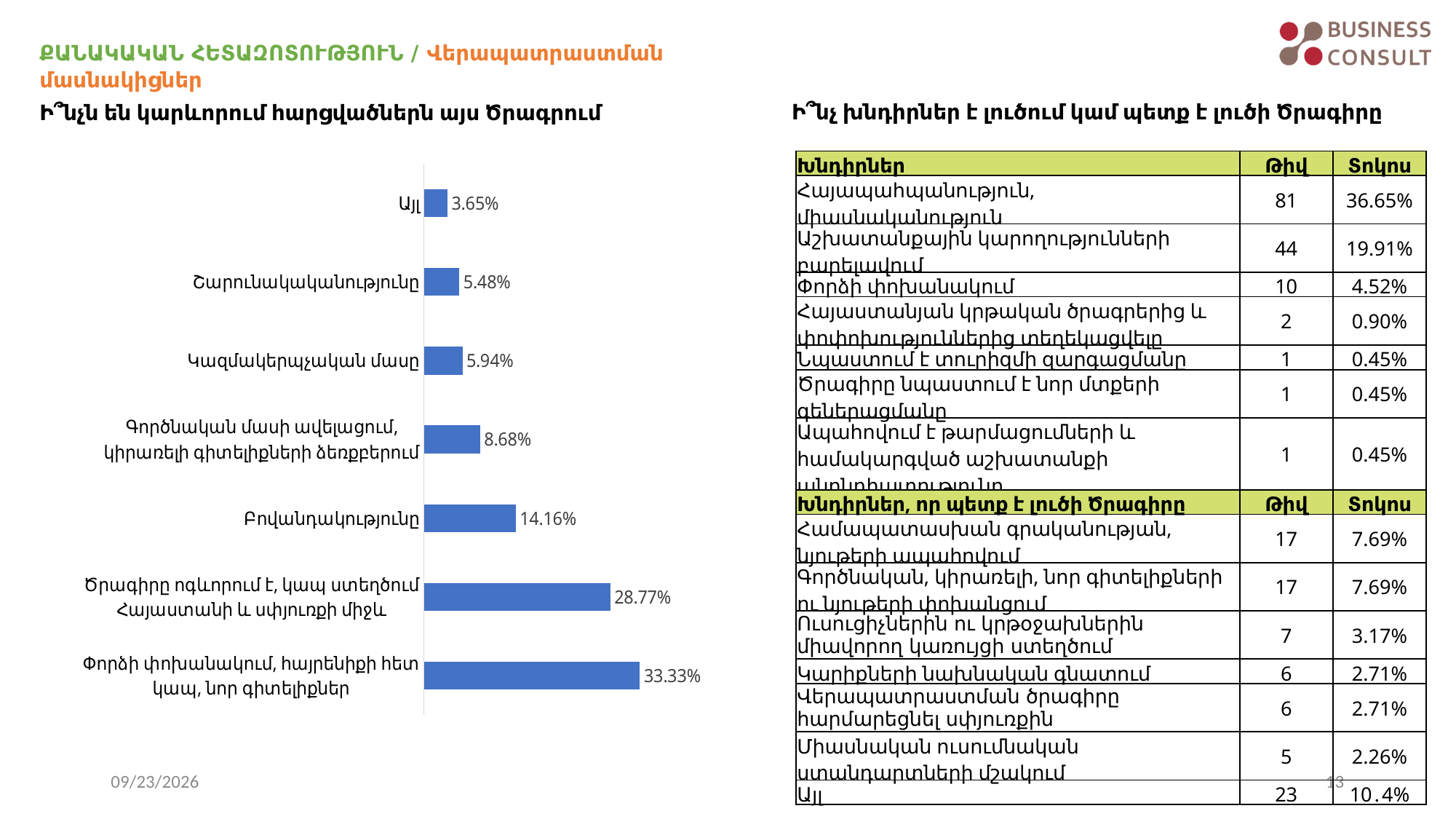
What is the title shown above the bar chart? Ի՞նչն են կարևորում հարցվածներն այս Ծրագրում What is the value for "Բովանդակությունը" in the bar chart? 14.16% What is the value for "Կազմակերպչական մասը" in the bar chart? 5.94% Which category has the lowest value in the bar chart? Այլ What is the difference between the values for "Փորձի փոխանակում, հայրենիքի հետ կապ, նոր գիտելիքներ" and "Ծրագիրը օգնորում է, կապ ստեղծում Հայաստանի և սփյուռքի միջև" in the bar chart? 4.56% What is the value for "Փորձի փոխանակում, հայրենիքի հետ կապ, նոր գիտելիքներ" in the bar chart? 33.33% What kind of chart is shown on the left side of the slide? Bar chart Which category has the highest value in the bar chart? Փորձի փոխանակում, հայրենիքի հետ կապ, նոր գիտելիքներ How many categories are plotted in the bar chart? 7 Which is larger in the bar chart: the value for "Շարունակականությունը" or the value for "Բովանդակությունը"? Բովանդակությունը What is the difference between the values for "Բովանդակությունը" and "Գործնական մասի ավելացում, կիրառելի գիտելիքների ձեռքբերում" in the bar chart? 5.48% What is the value for "Այլ" in the bar chart? 3.65%